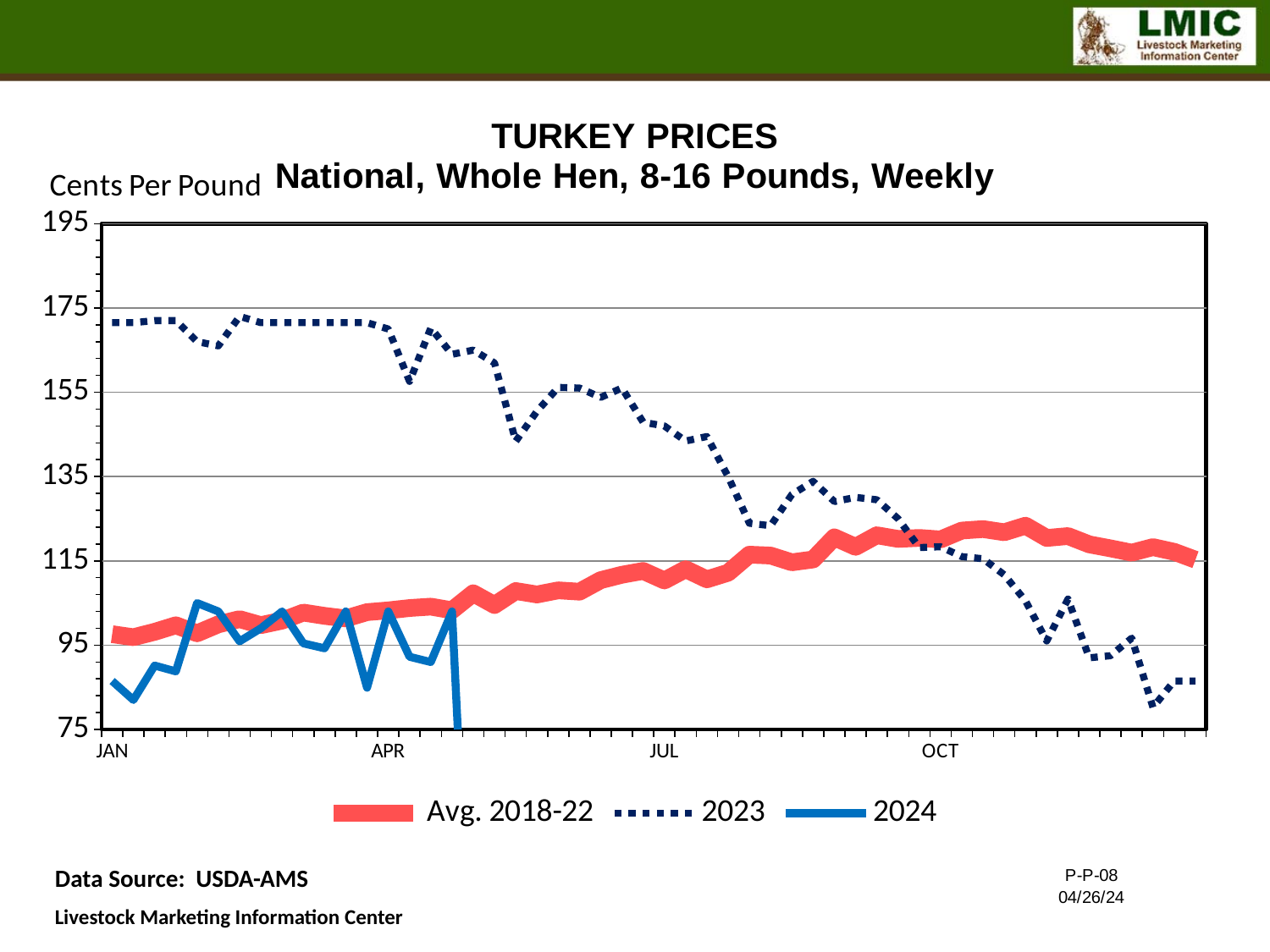
What unit is shown on the y axis of the chart? Cents Per Pound Does the Avg. 2018-22 series rise or fall from January to October? Rise What kind of chart is shown on the slide? Line chart In early April, which is higher, the 2023 series or the Avg. 2018-22 series? 2023 How many series does the legend list? 3 Does the 2023 series generally rise or fall from January to the end of the year? Fall Is the 2023 value at the end of the year greater or less than 95? less Is the Avg. 2018-22 value in January greater or less than 115? less Is the 2024 value at the start of January greater or less than 95? less In January, which series is higher, 2023 or 2024? 2023 Which series are listed in the legend? Avg. 2018-22, 2023, 2024